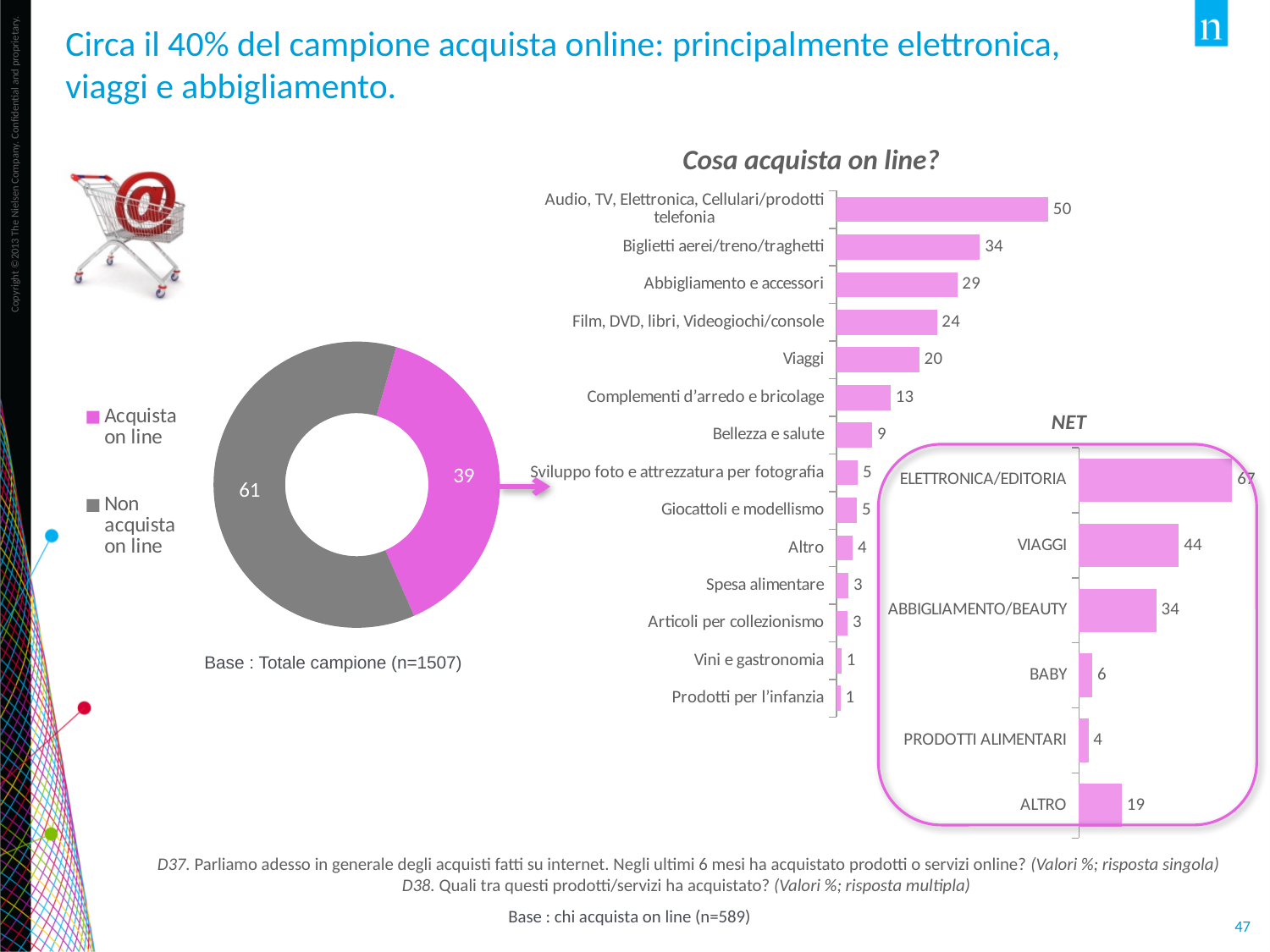
In the "Cosa acquista on line?" bar chart, what is the difference between "Abbigliamento e accessori" and "Viaggi"? 9 In the NET chart on the right, what is the difference between "ELETTRONICA/EDITORIA" and "ABBIGLIAMENTO/BEAUTY"? 33 In the "Cosa acquista on line?" bar chart, which category has the highest value? Audio, TV, Elettronica, Cellulari/prodotti telefonia In the "Cosa acquista on line?" bar chart, what is the value for "Biglietti aerei/treno/traghetti"? 34 In the NET chart on the right, what is the value for "VIAGGI"? 44 What type of chart is the "Cosa acquista on line?" chart? Bar chart In the donut chart on the left, what percentage of the sample buys online ("Acquista on line")? 39 How many entries does the legend of the donut chart on the left list? 2 In the "Cosa acquista on line?" bar chart, which is larger: "Film, DVD, libri, Videogiochi/console" or "Complementi d'arredo e bricolage"? Film, DVD, libri, Videogiochi/console How many categories are shown in the "Cosa acquista on line?" bar chart? 14 In the NET chart on the right, which category has the lowest value? PRODOTTI ALIMENTARI In the donut chart on the left, what is the value for "Non acquista on line"? 61